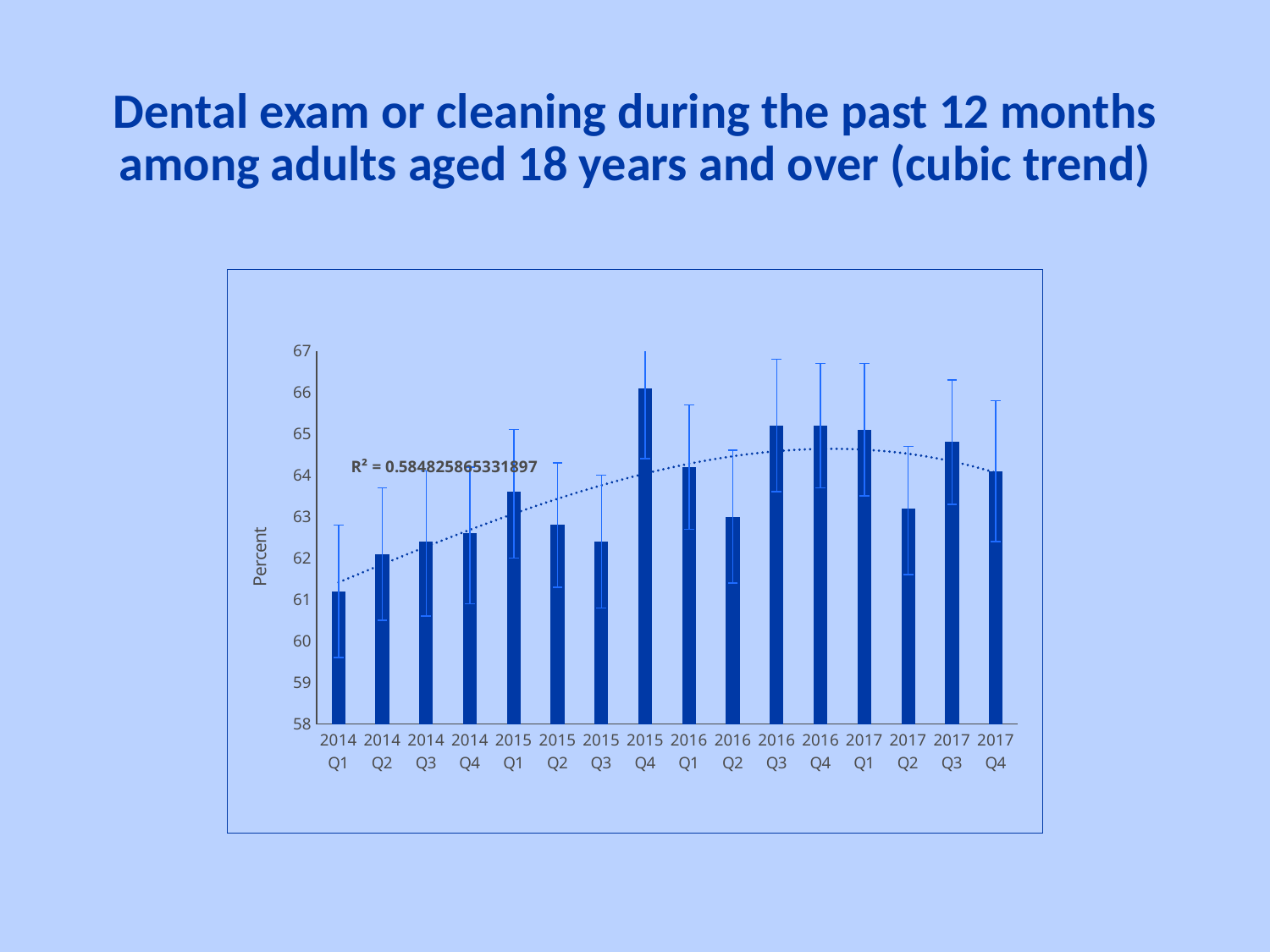
Is the value for 2017 Q2 greater or less than 64? less What R² value is printed on the chart for the cubic trend line? R² = 0.584825865331897 Which quarter has the highest value in the chart? 2015 Q4 Is the value for 2014 Q1 greater or less than 62? less Which is larger, the value for 2017 Q2 or the value for 2017 Q3? 2017 Q3 Is the value for 2014 Q3 greater or less than 63? less What kind of chart is shown on the slide? bar chart Which is larger, the value for 2016 Q2 or the value for 2016 Q3? 2016 Q3 Which quarter has the lowest value in the chart? 2014 Q1 How many bars (quarters) are plotted in the chart? 16 Do the values rise or fall from 2014 Q1 to 2014 Q4? rise